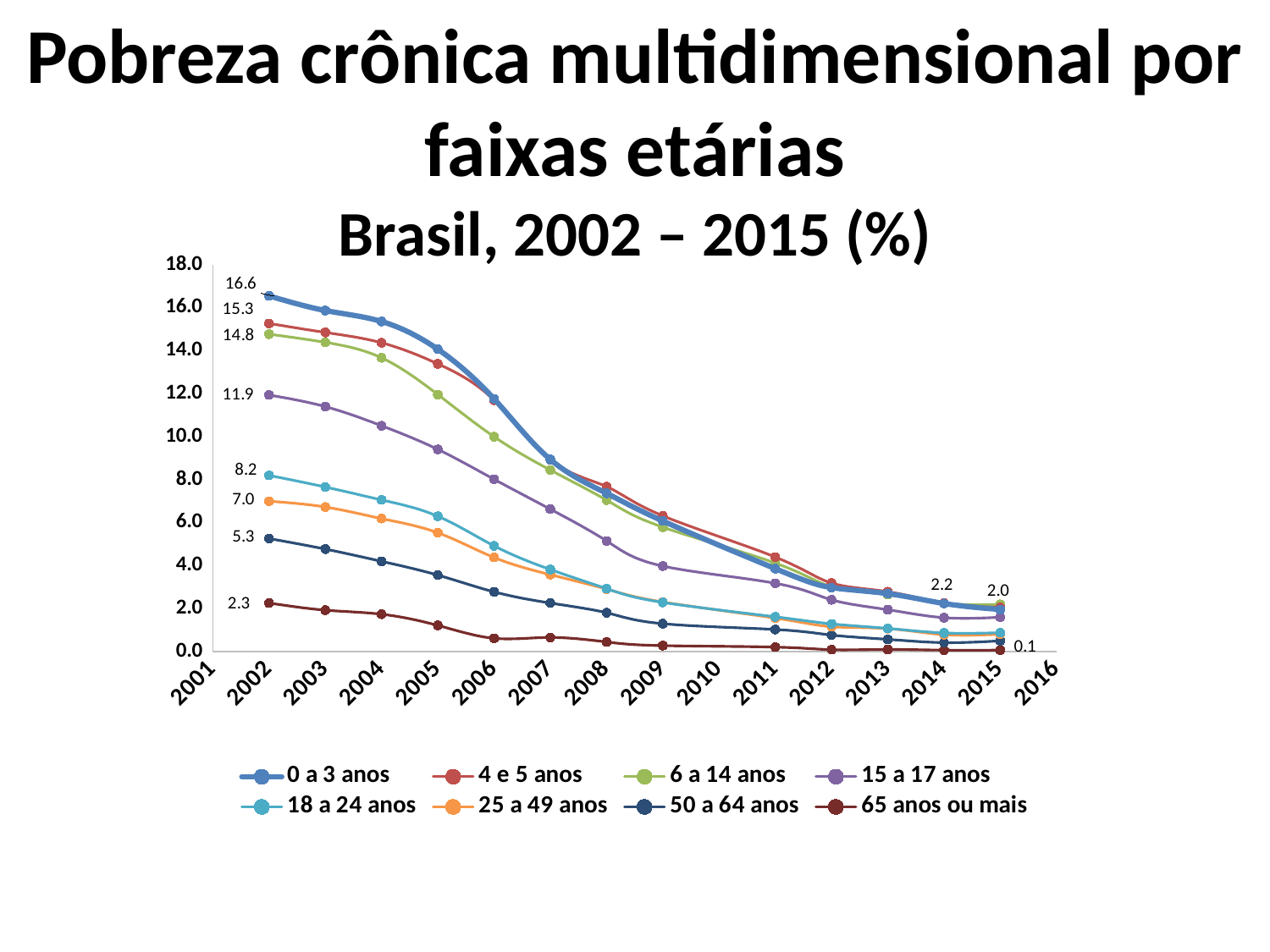
Do the values for the 0 a 3 anos series rise or fall from 2002 to 2015? Fall What is the difference between the 0 a 3 anos and 4 e 5 anos values in 2002? 1.3 What is the value for the 0 a 3 anos series in 2002? 16.6 What is the value for the 65 anos ou mais series in 2002? 2.3 What is the value for the 0 a 3 anos series in 2015? 2.0 How many series does the legend list? 8 Which is larger in 2002, the value for 18 a 24 anos or the value for 25 a 49 anos? 18 a 24 anos What is the value for the 15 a 17 anos series in 2002? 11.9 Which age group has the lowest value in 2002? 65 anos ou mais What kind of chart is shown on the slide? Line chart Which age group has the highest value in 2002? 0 a 3 anos Is the value for 15 a 17 anos in 2008 greater or less than 4.0? greater